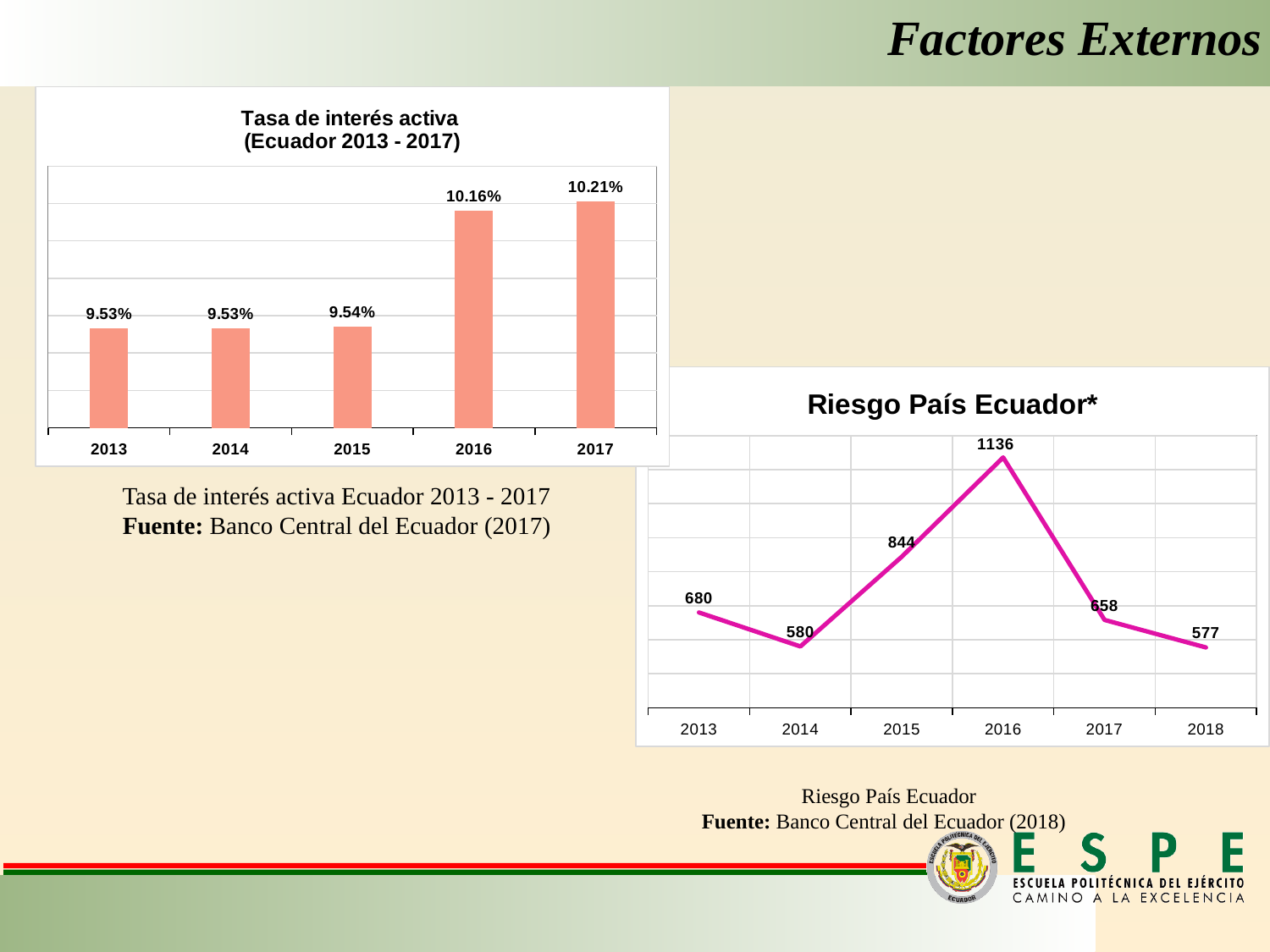
In the 'Tasa de interés activa (Ecuador 2013 - 2017)' chart, what is the difference between the 2017 and 2015 values? 0.67% In the 'Riesgo País Ecuador*' chart, which year has the highest value? 2016 In the 'Tasa de interés activa (Ecuador 2013 - 2017)' chart, what is the value for 2016? 10.16% In the 'Riesgo País Ecuador*' chart, how many data points are plotted? 6 In the 'Riesgo País Ecuador*' chart, which is larger, the value for 2013 or the value for 2017? 2013 What kind of chart is the 'Tasa de interés activa (Ecuador 2013 - 2017)' chart? bar chart In the 'Riesgo País Ecuador*' chart, which year has the lowest value? 2018 In the 'Tasa de interés activa (Ecuador 2013 - 2017)' chart, how many years are shown on the x axis? 5 In the 'Riesgo País Ecuador*' chart, what is the value for 2014? 580 In the 'Tasa de interés activa (Ecuador 2013 - 2017)' chart, which year has the highest value? 2017 What kind of chart is the 'Riesgo País Ecuador*' chart? line chart In the 'Riesgo País Ecuador*' chart, what is the difference between the 2016 and 2015 values? 292